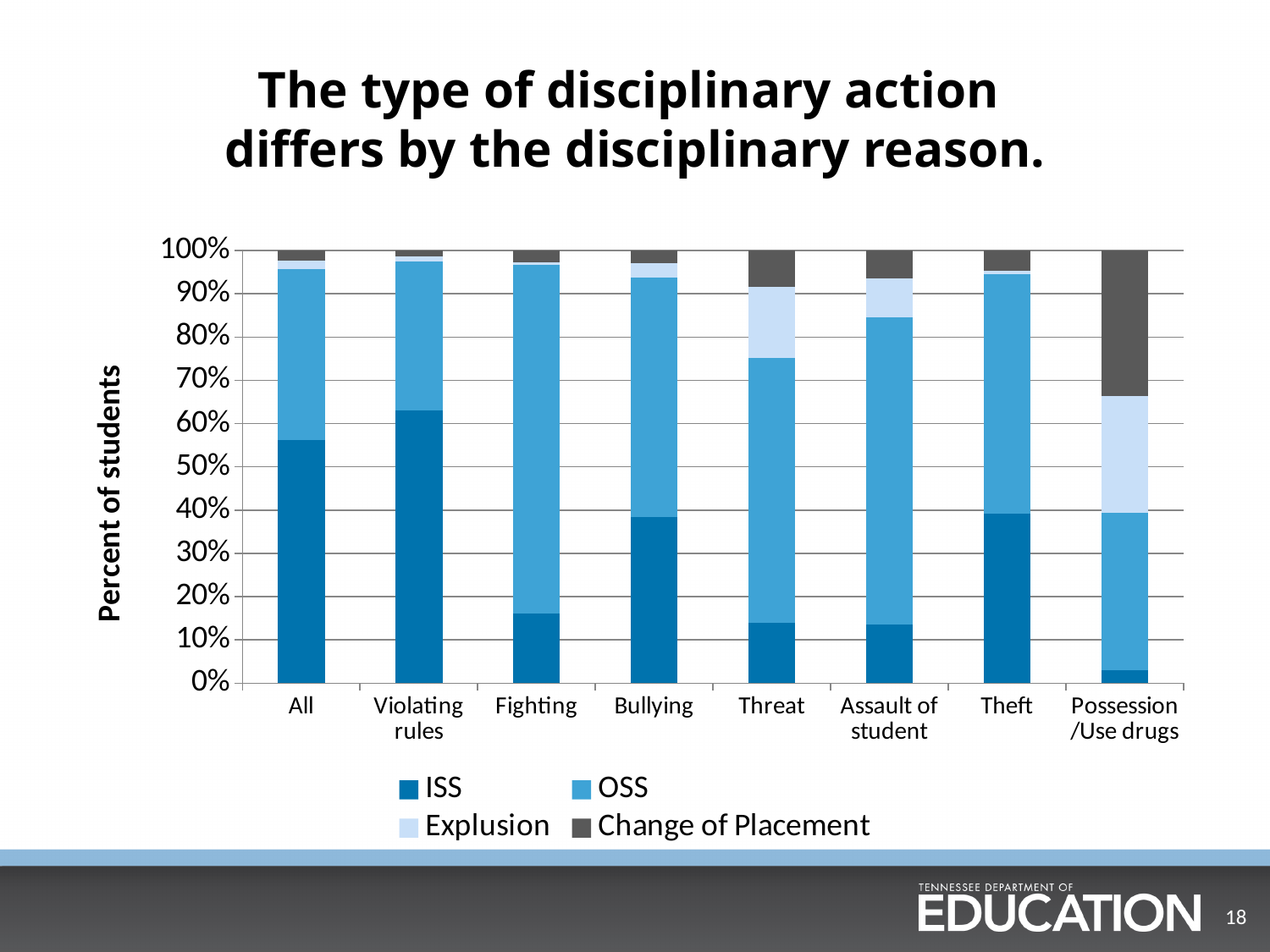
Which category has the largest Change of Placement segment? Possession /Use drugs Which has a larger ISS segment, Bullying or Fighting? Bullying What kind of chart is shown on the slide? Stacked bar chart Is the ISS value for Possession /Use drugs greater or less than 10%? less Is the ISS value for Fighting greater or less than 20%? less Which category has the smallest ISS segment? Possession /Use drugs Which has a larger Change of Placement segment, Possession /Use drugs or Theft? Possession /Use drugs What is the title of the y axis? Percent of students How many series does the legend list? 4 How many disciplinary reason categories are shown on the x axis? 8 Which category has the largest ISS segment? Violating rules Is the ISS value for All greater or less than 50%? greater